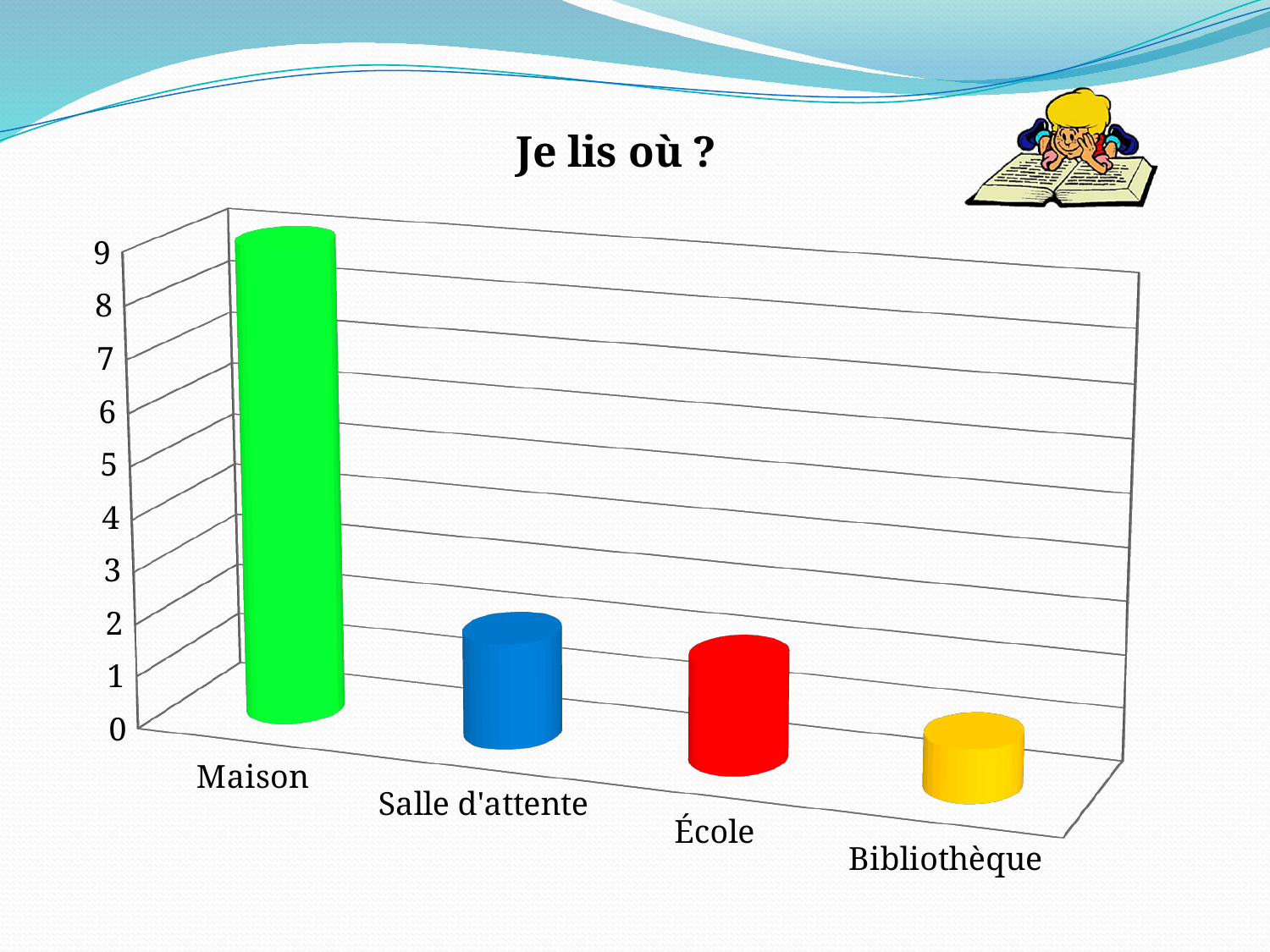
Is the value for Maison greater or less than 5? greater Is the value for École greater or less than 5? less Which is larger, the value for Maison or the value for Bibliothèque? Maison What is the title of the chart? Je lis où ? Which category has the highest value in the chart? Maison What is the highest value shown on the vertical axis of the chart? 9 What kind of chart is shown on the slide? bar chart Which is larger, the value for Maison or the value for École? Maison What colour is the bar for Maison? green Is the value for Bibliothèque greater or less than 4? less How many categories are shown on the x axis of the chart? 4